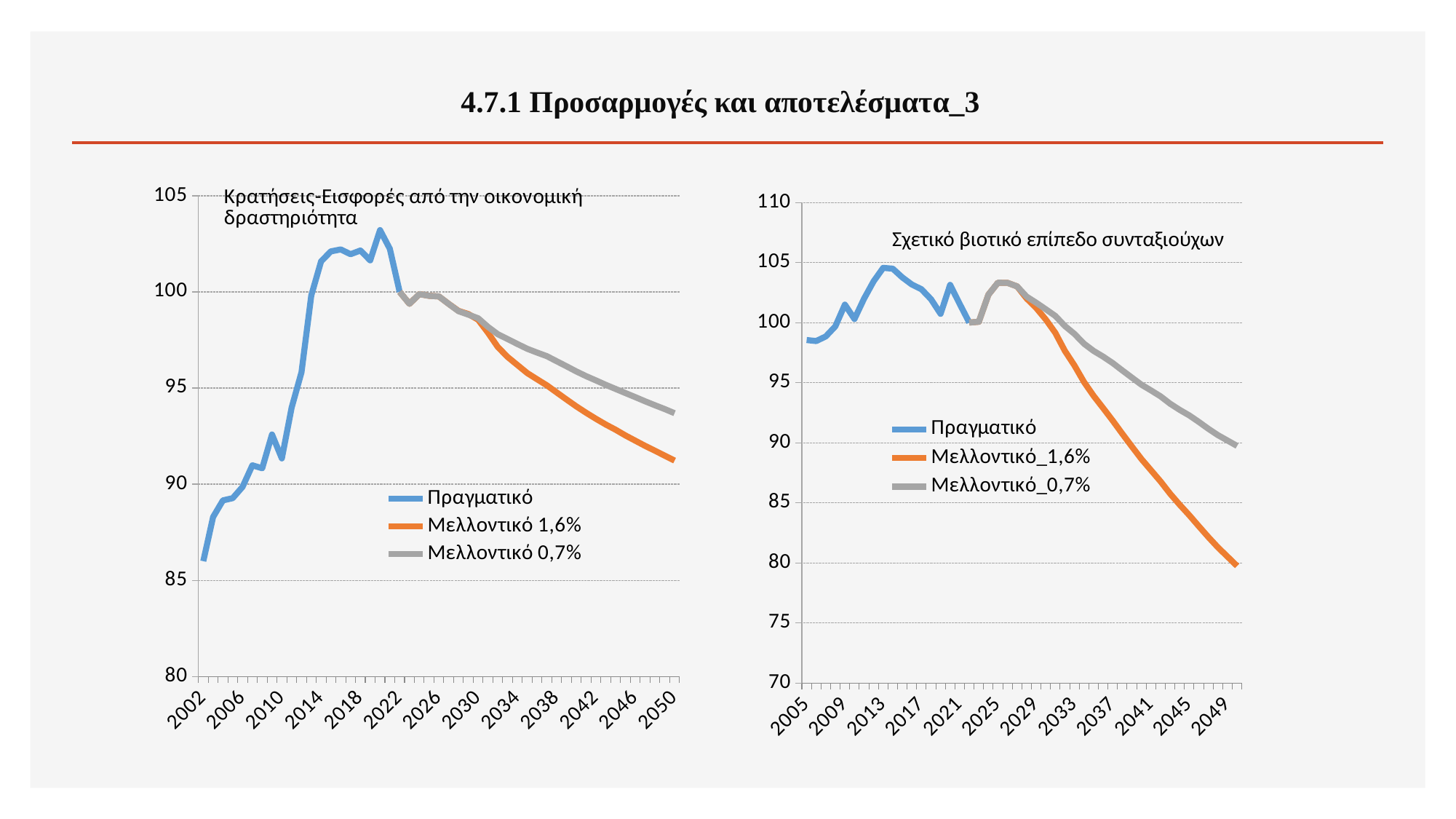
How many series does the legend of the right chart 'Σχετικό βιοτικό επίπεδο συνταξιούχων' list? 3 In the right chart 'Σχετικό βιοτικό επίπεδο συνταξιούχων', which series is drawn in blue? Πραγματικό In the right chart 'Σχετικό βιοτικό επίπεδο συνταξιούχων', is the value of Μελλοντικό_1,6% in 2049 greater or less than 85? less In the left chart 'Κρατήσεις-Εισφορές από την οικονομική δραστηριότητα', does the Πραγματικό series rise or fall from 2002 to 2014? Rise In the left chart 'Κρατήσεις-Εισφορές από την οικονομική δραστηριότητα', which series is drawn in orange? Μελλοντικό 1,6% What type of chart is the left chart titled 'Κρατήσεις-Εισφορές από την οικονομική δραστηριότητα'? Line chart In the left chart 'Κρατήσεις-Εισφορές από την οικονομική δραστηριότητα', is the value of Μελλοντικό 1,6% in 2050 greater or less than 95? less In the right chart 'Σχετικό βιοτικό επίπεδο συνταξιούχων', which series is higher in 2049, Μελλοντικό_1,6% or Μελλοντικό_0,7%? Μελλοντικό_0,7% In the left chart 'Κρατήσεις-Εισφορές από την οικονομική δραστηριότητα', which series is higher in 2050, Μελλοντικό 1,6% or Μελλοντικό 0,7%? Μελλοντικό 0,7% In the right chart 'Σχετικό βιοτικό επίπεδο συνταξιούχων', is the value of Πραγματικό in 2005 greater or less than 95? greater In the right chart 'Σχετικό βιοτικό επίπεδο συνταξιούχων', does the Μελλοντικό_1,6% series rise or fall from 2029 to 2049? Fall